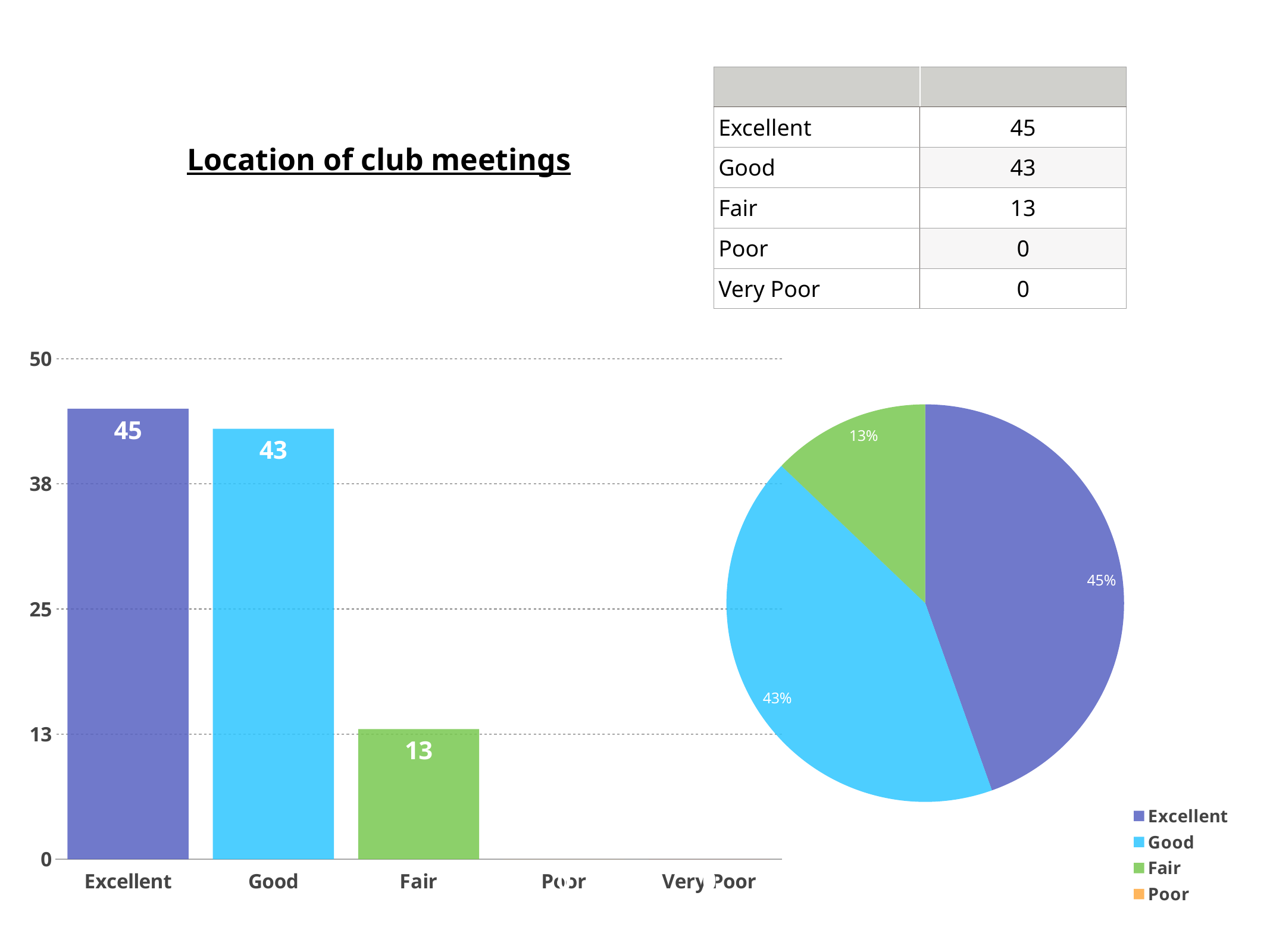
In the pie chart, what share does the Good slice have? 43% In the pie chart, what share does the Fair slice have? 13% In the bar chart, what is the value for Fair? 13 In the bar chart, what is the value for Excellent? 45 In the bar chart, which is larger, the value for Good or the value for Fair? Good In the bar chart, is the value for Good greater or less than 38? greater What kind of chart is on the left of the slide? bar chart How many entries does the pie chart's legend list? 4 In the bar chart, which category has the highest value? Excellent In the bar chart, what is the difference between the values for Good and Fair? 30 In the bar chart, do the values rise or fall from Excellent to Very Poor? fall How many categories are shown on the x axis of the bar chart? 5